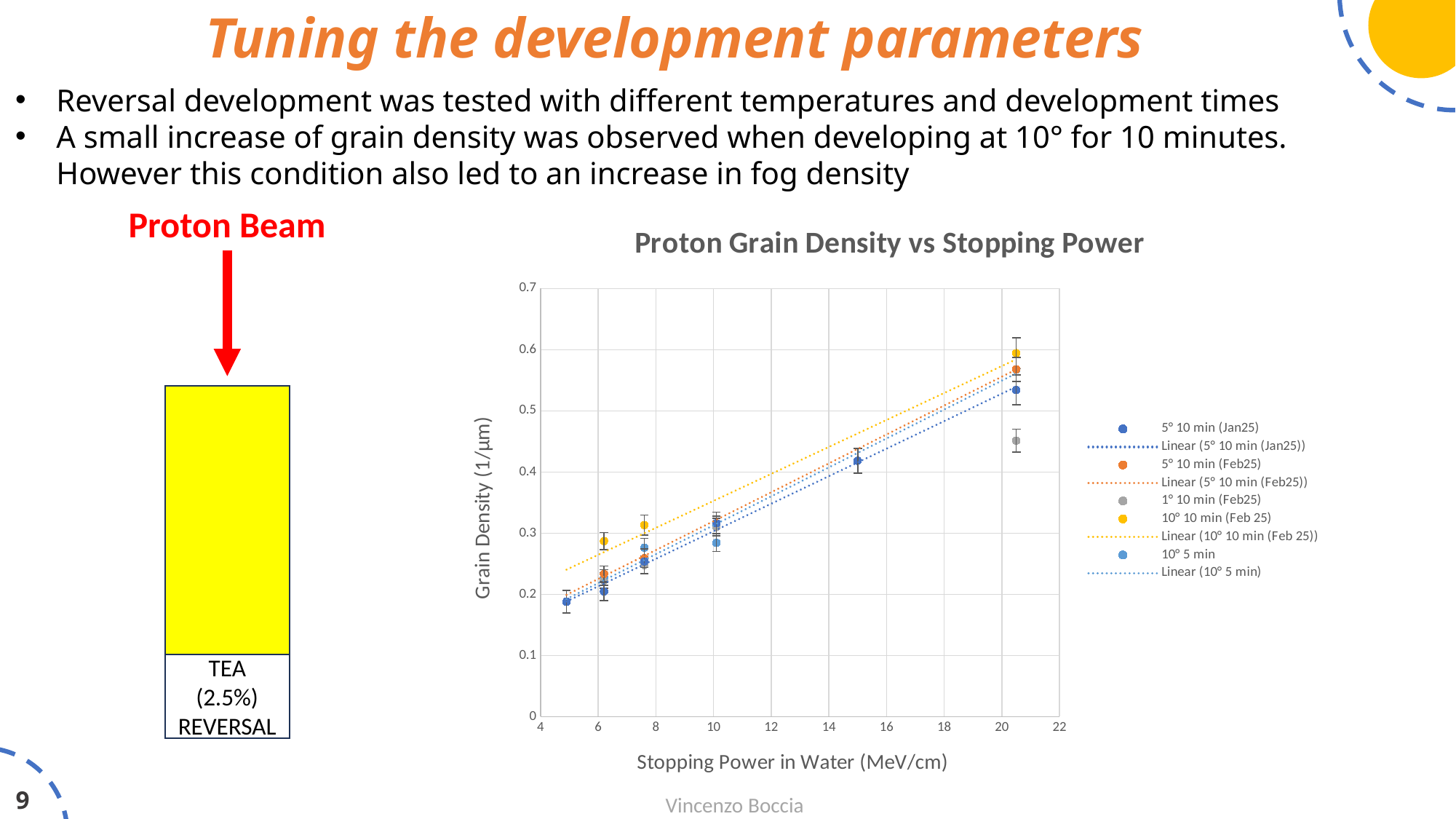
Which series has the lowest grain density at the highest stopping power (around 20.5 MeV/cm)? 1° 10 min (Feb25) What kind of chart is shown on the slide? scatter chart What is the label of the x axis of the chart? Stopping Power in Water (MeV/cm) What is the maximum value shown on the y axis of the chart? 0.7 Is the grain density of the 10° 10 min (Feb 25) series at the highest stopping power (around 20.5 MeV/cm) greater or less than 0.5? greater Is the grain density of the 1° 10 min (Feb25) series at the highest stopping power (around 20.5 MeV/cm) greater or less than 0.5? less What is the title of the chart on the slide? Proton Grain Density vs Stopping Power Is the grain density of the 5° 10 min (Jan25) series at the lowest stopping power (around 5 MeV/cm) greater or less than 0.2? less How many entries does the chart's legend list? 8 At a stopping power of about 6 MeV/cm, which series has the larger grain density: 10° 10 min (Feb 25) or 5° 10 min (Jan25)? 10° 10 min (Feb 25) Does grain density rise or fall as stopping power increases along the x axis? rise